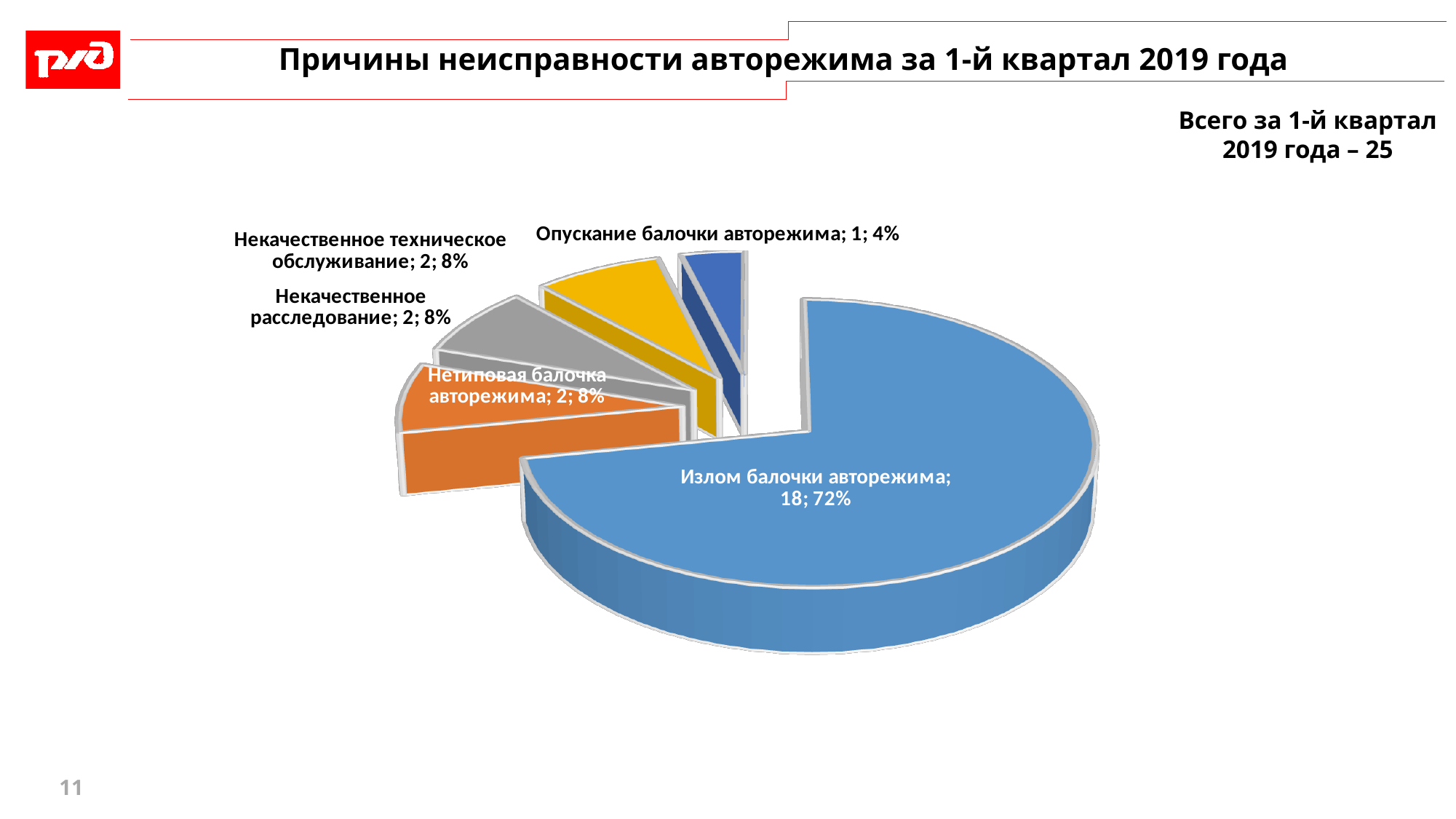
How many slices does the pie chart have? 5 What share of the pie does "Опускание балочки авторежима" take? 4% What is the title of the chart on the slide? Причины неисправности авторежима за 1-й квартал 2019 года Which category has the largest slice? Излом балочки авторежима Which category has the smallest slice? Опускание балочки авторежима What is the value for "Опускание балочки авторежима"? 1 What is the difference between the values for "Излом балочки авторежима" and "Нетиповая балочка авторежима"? 16 Which is larger, the value for "Некачественное техническое обслуживание" or the value for "Опускание балочки авторежима"? Некачественное техническое обслуживание What is the value for "Некачественное расследование"? 2 What kind of chart is shown on the slide? Pie chart What share of the pie does "Излом балочки авторежима" take? 72% What is the value for "Излом балочки авторежима"? 18